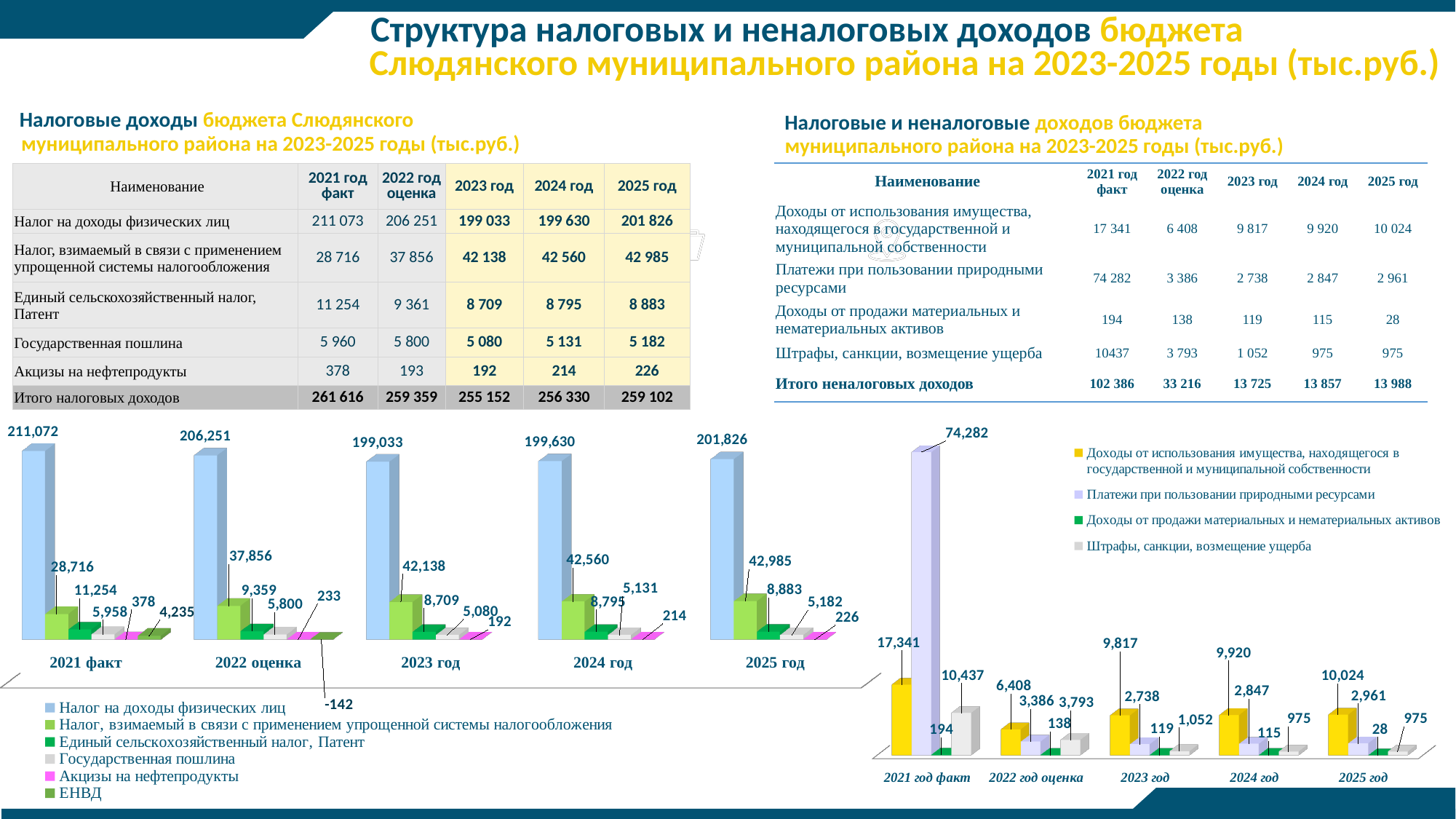
How many series does the legend of the right chart list? 4 In the left chart, which year has the highest value for Налог на доходы физических лиц? 2021 факт How many series does the legend of the left chart list? 6 What type of chart is the left chart? Bar chart In the left chart, what is the difference between the Налог на доходы физических лиц values for 2025 год and 2024 год? 2,196 In the left chart, what is the value of Налог на доходы физических лиц for 2023 год? 199,033 How many year categories are shown on the x axis of the right chart? 5 In the left chart, what is the value of Налог, взимаемый в связи с применением упрощенной системы налогообложения for 2022 оценка? 37,856 In the right chart, what is the value of Платежи при пользовании природными ресурсами for 2021 год факт? 74,282 In the right chart, which is larger: Доходы от использования имущества for 2023 год or Платежи при пользовании природными ресурсами for 2023 год? Доходы от использования имущества (9,817) In the right chart, what is the value of Доходы от продажи материальных и нематериальных активов for 2025 год? 28 In the right chart, which year has the lowest value for Доходы от использования имущества, находящегося в государственной и муниципальной собственности? 2022 год оценка